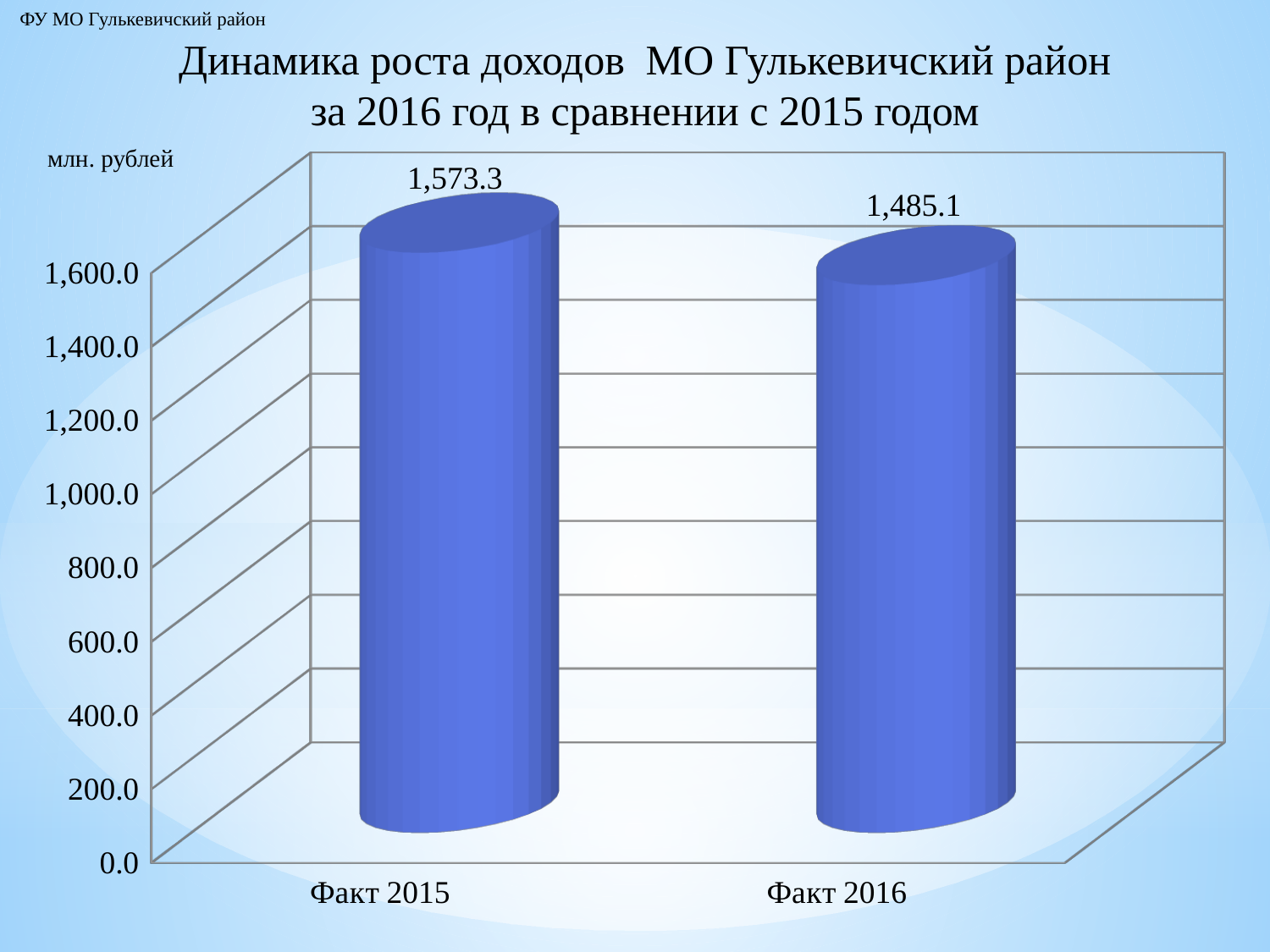
What is the difference between the values for Факт 2015 and Факт 2016? 88.2 Which category has the highest value? Факт 2015 What is the value for Факт 2016? 1,485.1 Do the values rise or fall from Факт 2015 to Факт 2016? fall What kind of chart is shown on the slide? bar chart Which category has the lowest value? Факт 2016 What unit is indicated for the values on the chart? млн. рублей What is the value for Факт 2015? 1,573.3 Is the value for Факт 2016 greater or less than 1,400.0? greater How many categories are shown on the chart? 2 What is the title of the chart? Динамика роста доходов МО Гулькевичский район за 2016 год в сравнении с 2015 годом Which is larger, the value for Факт 2015 or the value for Факт 2016? Факт 2015